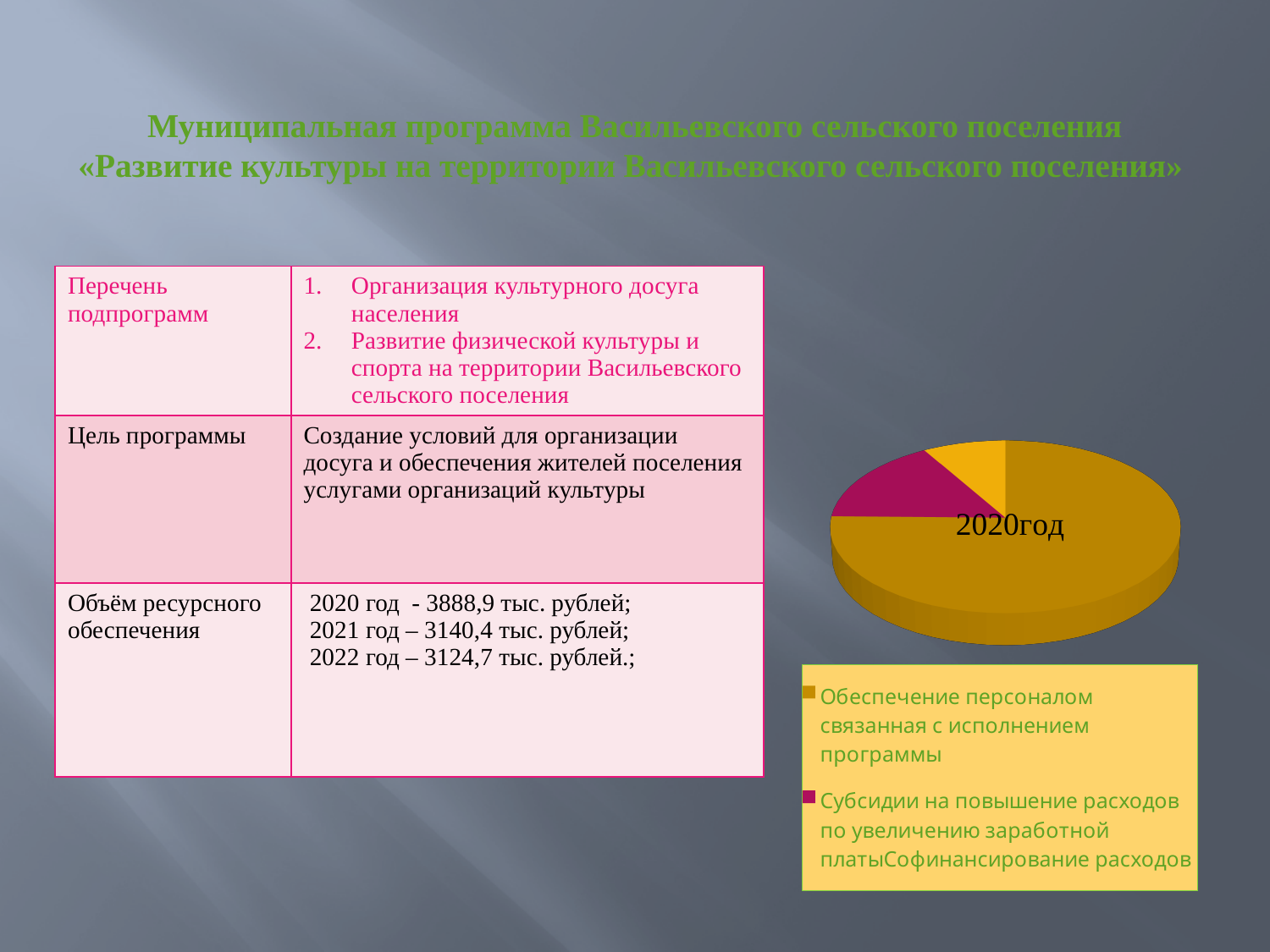
What kind of chart is shown on the slide? pie chart How many slices does the pie chart have? 3 Which legend category has the largest slice in the pie chart? Обеспечение персоналом связанная с исполнением программы Which slice is larger in the pie chart: "Обеспечение персоналом связанная с исполнением программы" or "Субсидии на повышение расходов по увеличению заработной платыСофинансирование расходов"? Обеспечение персоналом связанная с исполнением программы How many entries does the legend of the pie chart list? 2 What colour is the legend marker for "Субсидии на повышение расходов по увеличению заработной платыСофинансирование расходов"? magenta What label is printed on the pie chart? 2020год